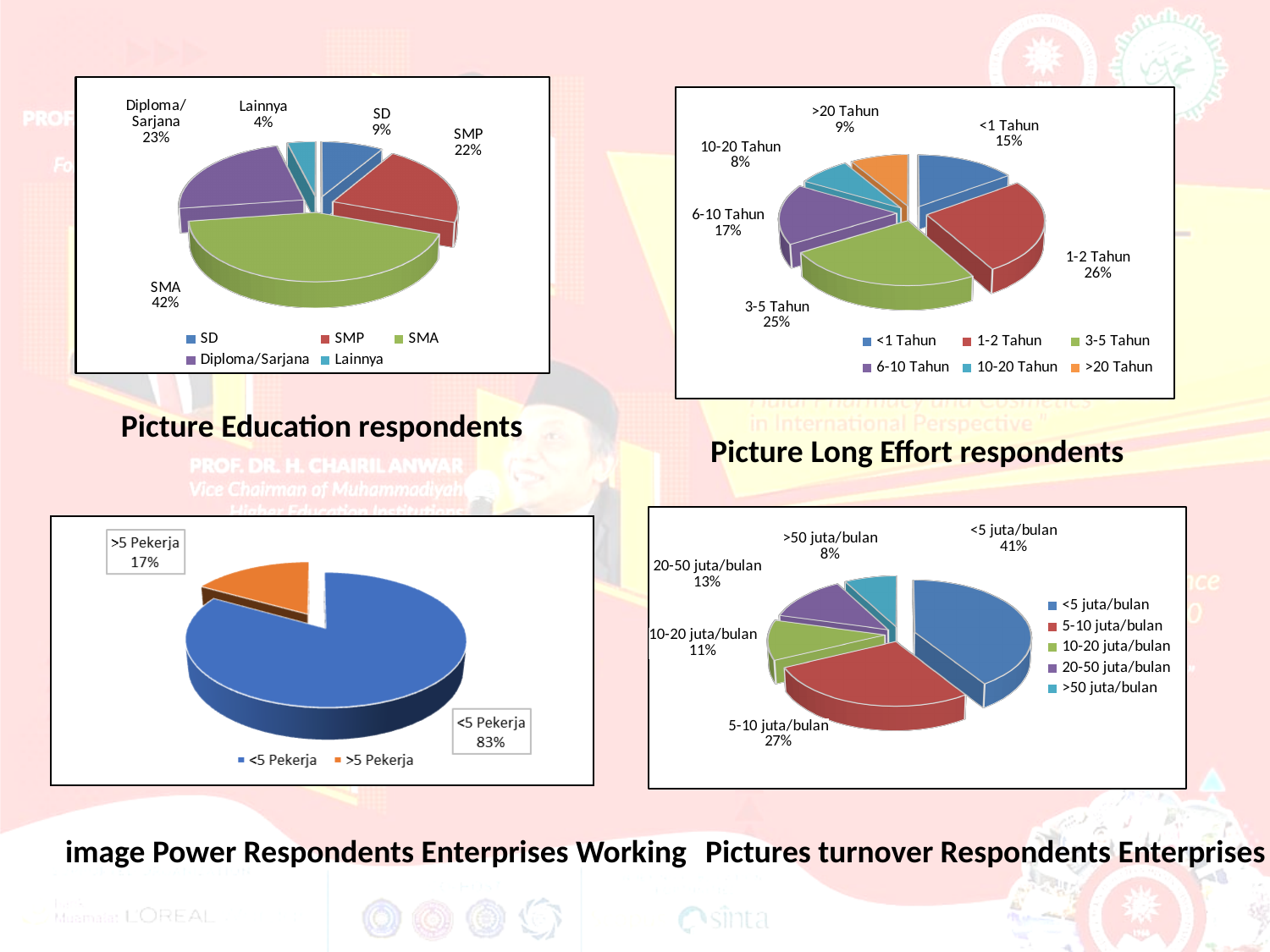
In the bottom-right pie chart (Pictures turnover Respondents Enterprises), which category has the largest share? <5 juta/bulan In the top-left pie chart (Picture Education respondents), which education category has the smallest share? Lainnya In the top-right pie chart (Picture Long Effort respondents), what share of respondents are in the 1-2 Tahun category? 26% In the top-right pie chart (Picture Long Effort respondents), how many categories are shown? 6 In the bottom-left pie chart (image Power Respondents Enterprises Working), what share of respondents have <5 Pekerja? 83% In the top-right pie chart (Picture Long Effort respondents), which category has the smallest share? 10-20 Tahun How many categories does the legend of the top-left pie chart (Picture Education respondents) list? 5 In the top-left pie chart (Picture Education respondents), what is the difference between the SMP and SD shares? 13% In the top-right pie chart (Picture Long Effort respondents), which is larger: 6-10 Tahun or <1 Tahun? 6-10 Tahun In the top-left pie chart (Picture Education respondents), what share of respondents have SMA education? 42% In the bottom-right pie chart (Pictures turnover Respondents Enterprises), what is the combined share of 10-20 juta/bulan and 20-50 juta/bulan? 24% What type of chart is the bottom-left chart (image Power Respondents Enterprises Working)? Pie chart